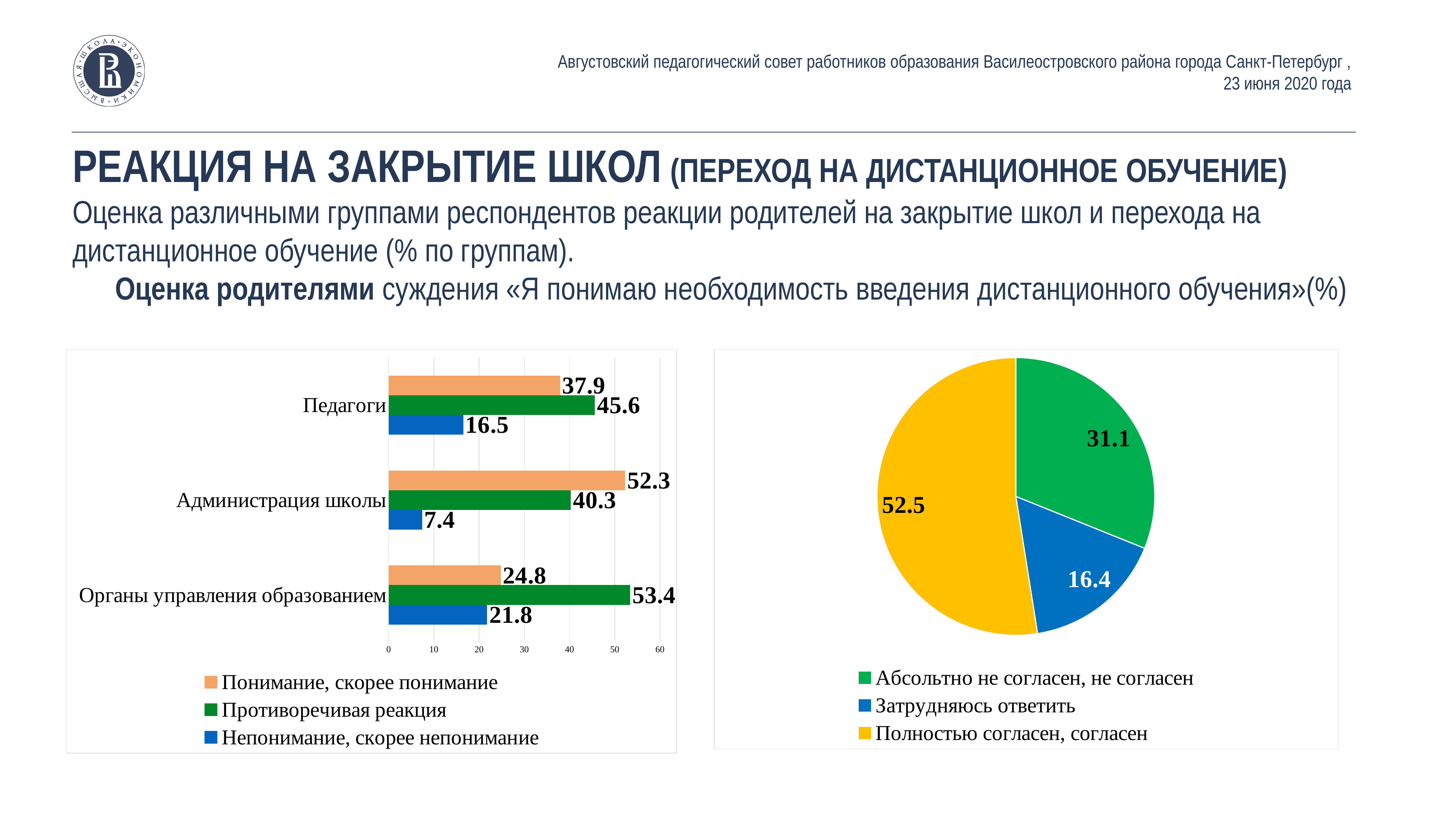
What kind of chart is shown on the left of the slide? Bar chart In the bar chart on the left, what is the value for Педагоги in the series Противоречивая реакция? 45.6 In the bar chart on the left, which category has the lowest value in the series Непонимание, скорее непонимание? Администрация школы In the bar chart on the left, what is the value for Органы управления образованием in the series Непонимание, скорее непонимание? 21.8 In the bar chart on the left, what is the value for Администрация школы in the series Понимание, скорее понимание? 52.3 In the bar chart on the left, which category has the highest value in the series Противоречивая реакция? Органы управления образованием In the pie chart on the right, which slice is the smallest? Затрудняюсь ответить How many slices does the pie chart on the right have? 3 In the bar chart on the left, which is larger for Педагоги: Понимание, скорее понимание or Противоречивая реакция? Противоречивая реакция In the bar chart on the left, what is the difference between the Понимание, скорее понимание values for Администрация школы and Органы управления образованием? 27.5 In the pie chart on the right, what is the value for Полностью согласен, согласен? 52.5 How many series does the legend of the bar chart on the left list? 3